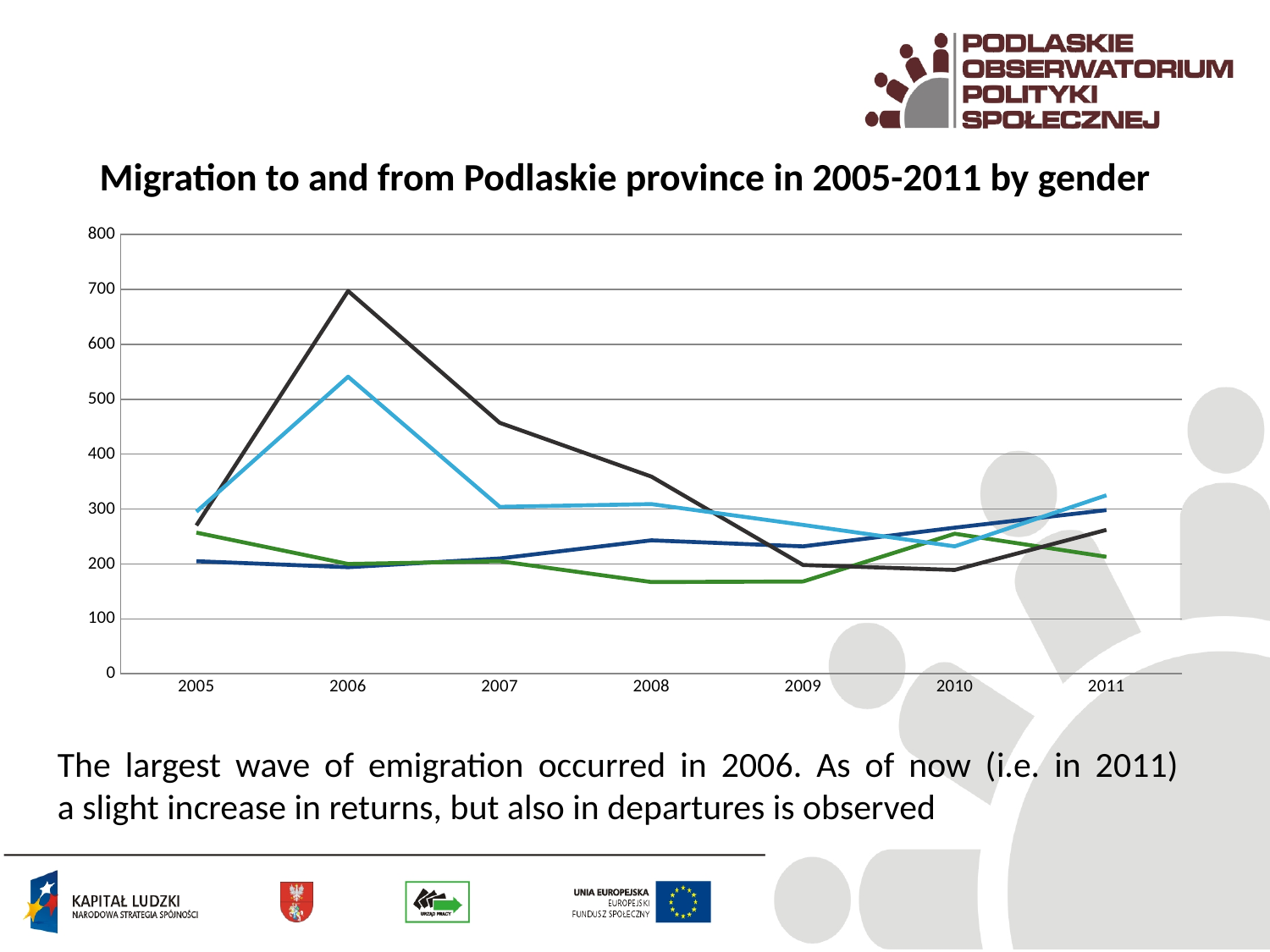
In which year does the black line reach its highest value? 2006 Is the value of the dark blue line in 2005 greater or less than 300? less What kind of chart is shown on the slide? Line chart Is the value of the black line in 2006 greater or less than 600? greater How many lines are plotted on the chart? 4 Does the black line rise or fall between 2006 and 2010? Fall How many years are shown on the x axis of the chart? 7 Is the value of the green line in 2008 greater or less than 200? less What is the title of the chart? Migration to and from Podlaskie province in 2005-2011 by gender In which year does the light blue line reach its highest value? 2006 In 2006, which line has the larger value, the black line or the light blue line? The black line